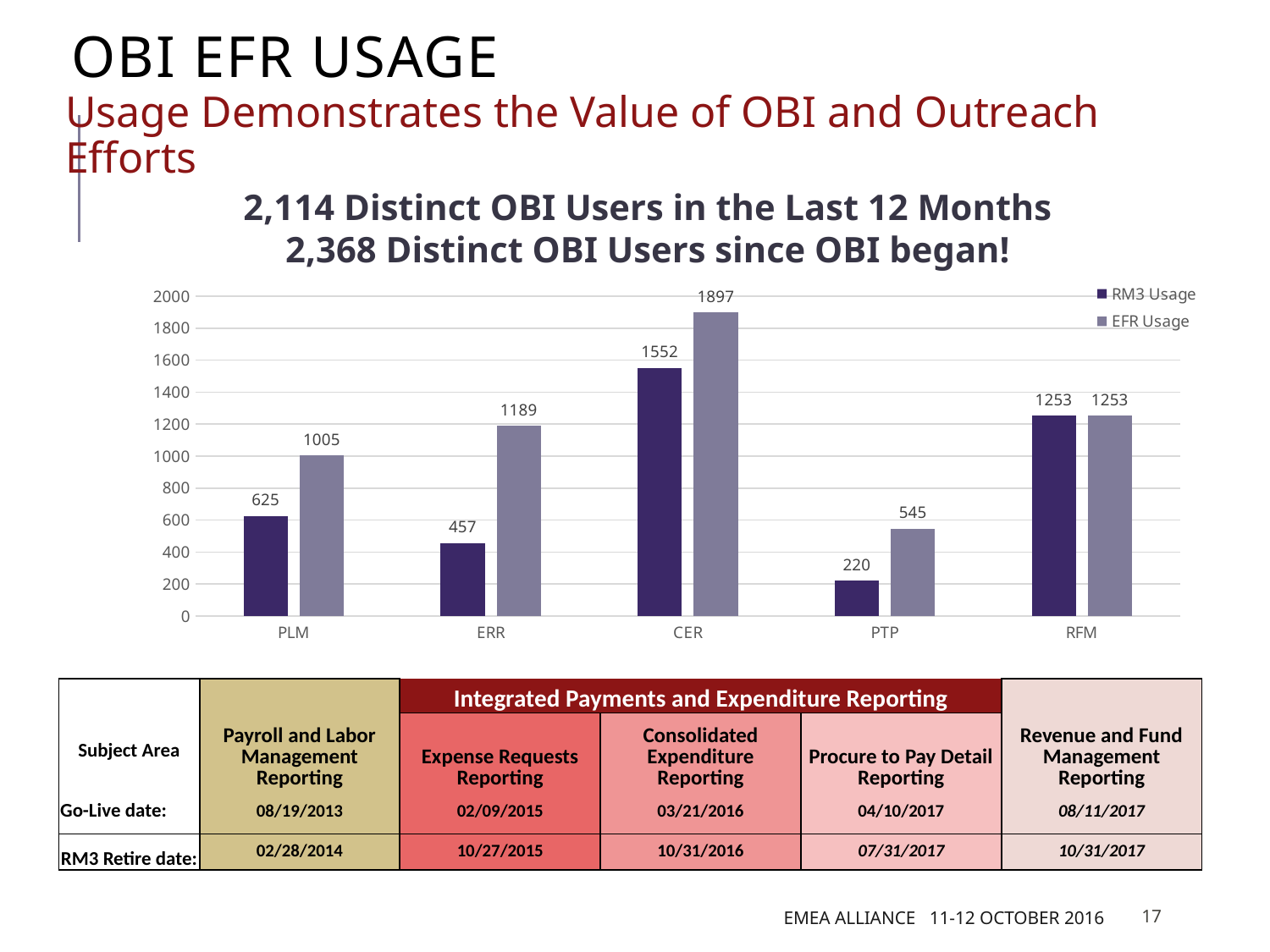
What is the EFR Usage value for CER? 1897 What is the RM3 Usage value for PTP? 220 Is the EFR Usage value for PTP greater or less than 600? less Which category has the lowest RM3 Usage? PTP What is the RM3 Usage value for PLM? 625 How many categories are shown on the x axis? 5 What is the difference between EFR Usage and RM3 Usage for RFM? 0 Which category has the highest EFR Usage? CER What kind of chart is shown on the slide? bar chart What is the difference between EFR Usage and RM3 Usage for ERR? 732 How many series does the legend list? 2 Which is larger for PLM, RM3 Usage or EFR Usage? EFR Usage